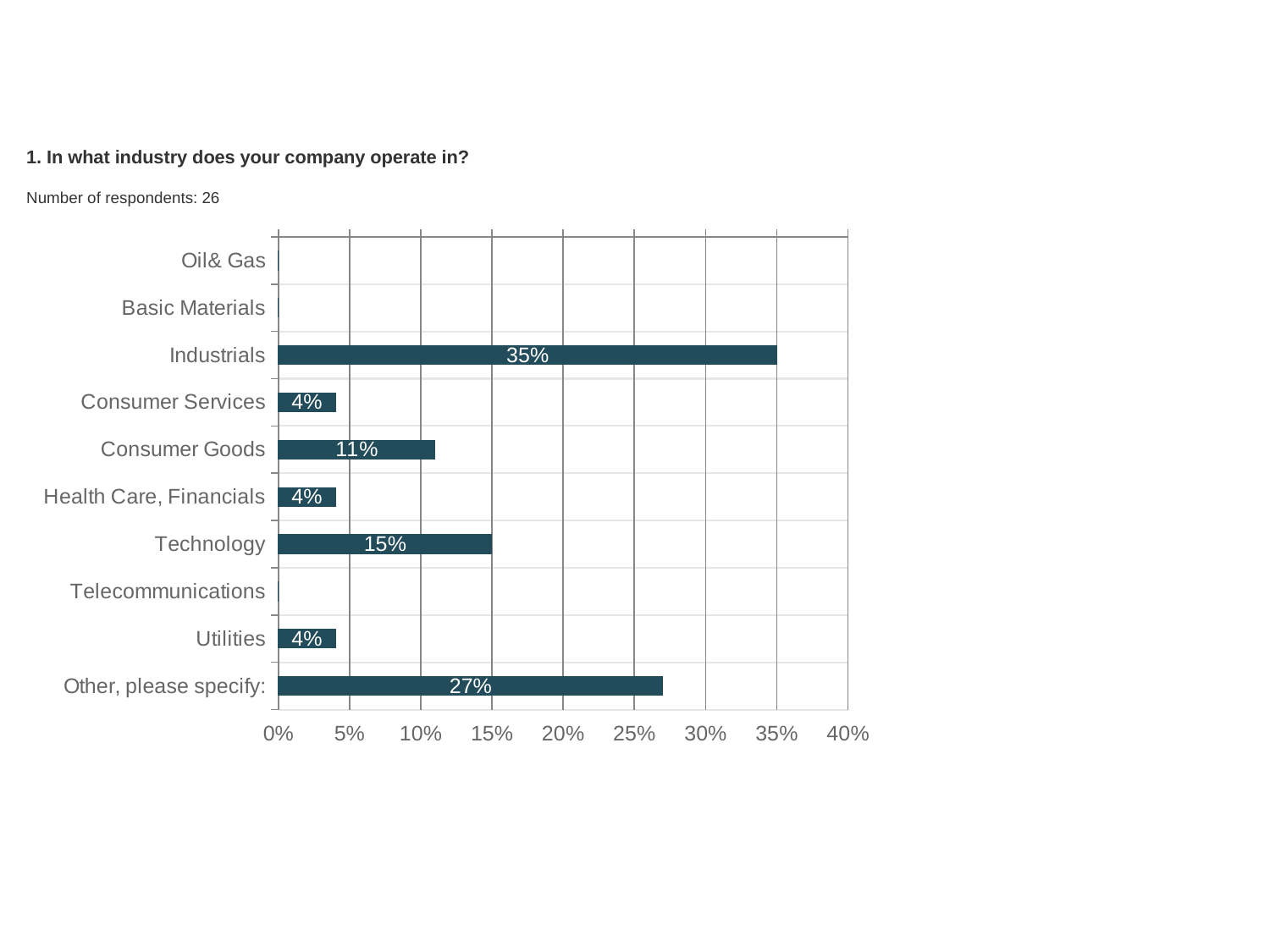
What is the value for Technology? 15% How many respondents answered the question shown on the slide? 26 Which industry category has the highest percentage? Industrials What is the difference between the Technology value and the Consumer Goods value? 4% What percentage of respondents operate in Industrials? 35% What is the value for Consumer Goods? 11% What is the difference between the Industrials value and the Other, please specify value? 8% How many industry categories are listed on the chart? 10 Which is larger, the value for Technology or the value for Consumer Goods? Technology What kind of chart is shown on the slide? Bar chart What is the value for Other, please specify? 27% Is the value for Other, please specify greater or less than 25%? greater